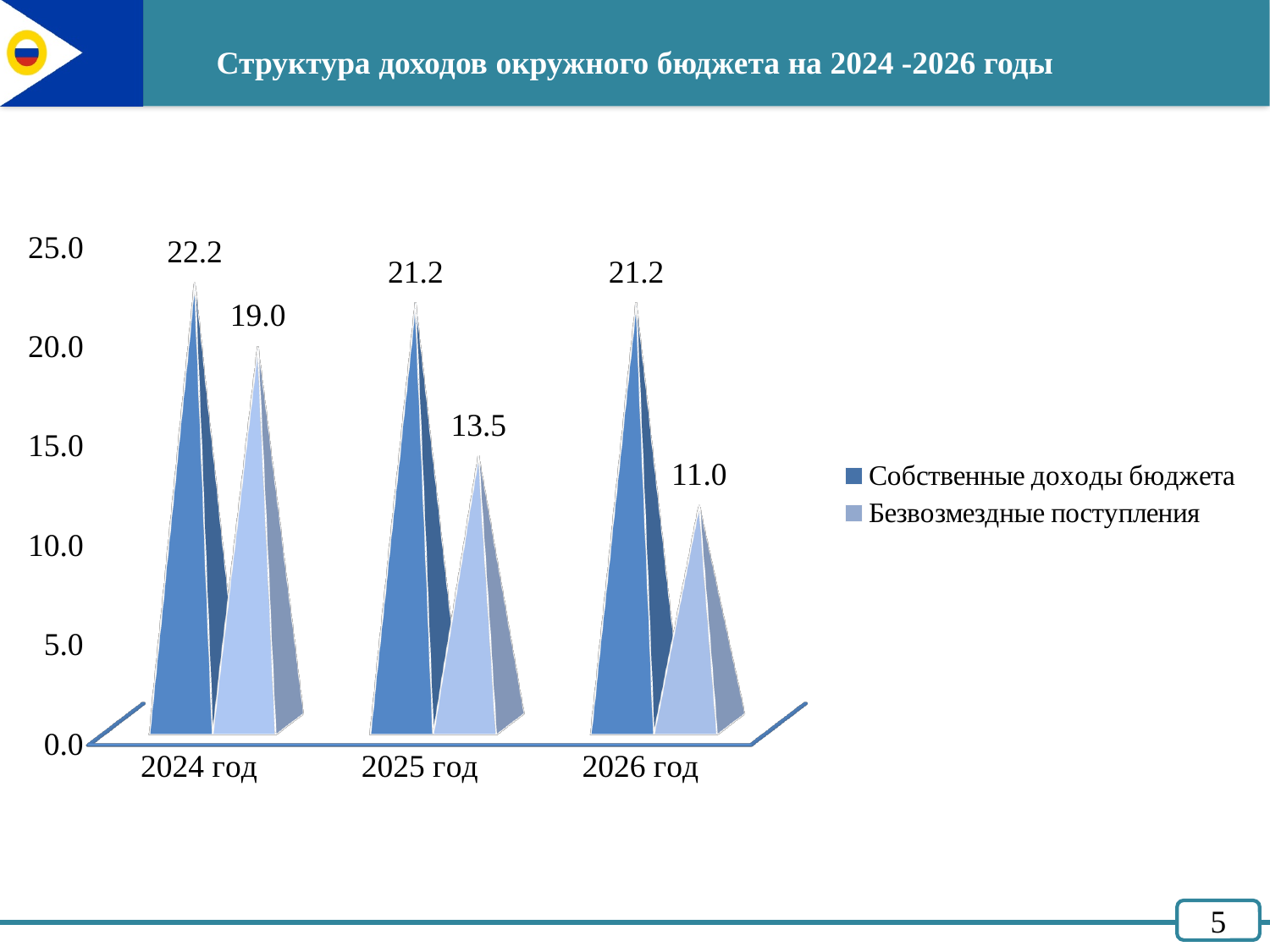
What is the difference between Безвозмездные поступления in 2024 год and 2026 год? 8.0 What is the value of Безвозмездные поступления for 2026 год? 11.0 What is the difference between Собственные доходы бюджета and Безвозмездные поступления in 2025 год? 7.7 In which year is Безвозмездные поступления lowest? 2026 год What is the value of Безвозмездные поступления for 2025 год? 13.5 How many years are shown on the x axis of the chart? 3 How many series does the chart legend list? 2 Does Безвозмездные поступления rise or fall from 2024 год to 2026 год? fall What is the value of Собственные доходы бюджета for 2026 год? 21.2 What is the value of Собственные доходы бюджета for 2024 год? 22.2 In which year is Безвозмездные поступления highest? 2024 год Which is larger in 2024 год: Собственные доходы бюджета or Безвозмездные поступления? Собственные доходы бюджета